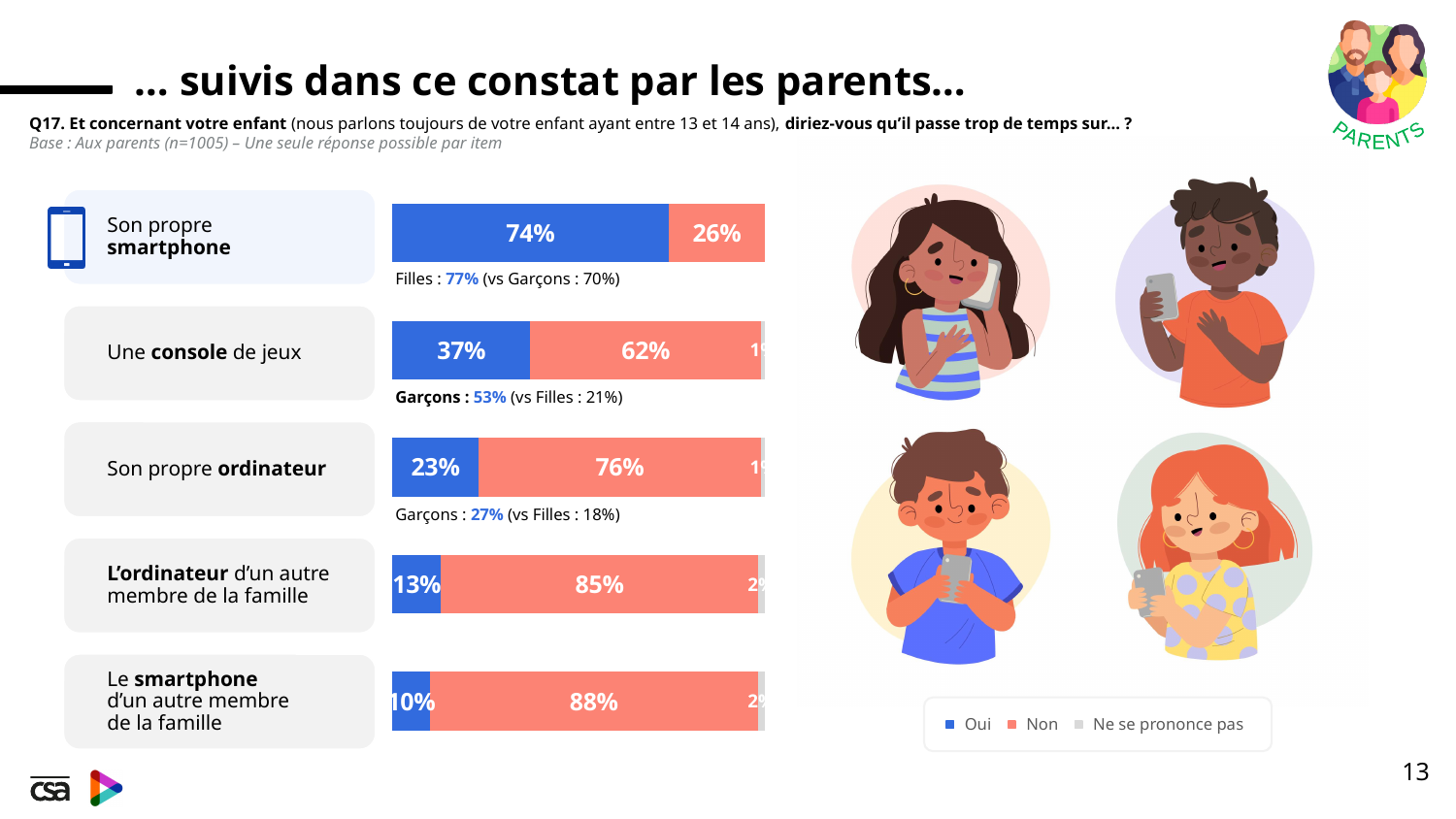
Which item has the lowest "Oui" percentage? Le smartphone d'un autre membre de la famille What is the "Oui" value for "Son propre ordinateur"? 23% Which item has the highest "Oui" percentage? Son propre smartphone What is the difference between the "Oui" values for "Son propre smartphone" and "Une console de jeux"? 37 percentage points What percentage of parents answered "Oui" for "Son propre smartphone"? 74% What is the "Non" value for "Le smartphone d'un autre membre de la famille"? 88% How many items (categories) are shown in the chart? 5 What percentage of parents answered "Non" for "Une console de jeux"? 62% How many series does the legend list? 3 What is the total of the "Oui" and "Non" values for "Son propre smartphone"? 100% What kind of chart is shown on the slide? Stacked bar chart Which is larger: the "Non" value for "L'ordinateur d'un autre membre de la famille" or the "Non" value for "Son propre ordinateur"? L'ordinateur d'un autre membre de la famille